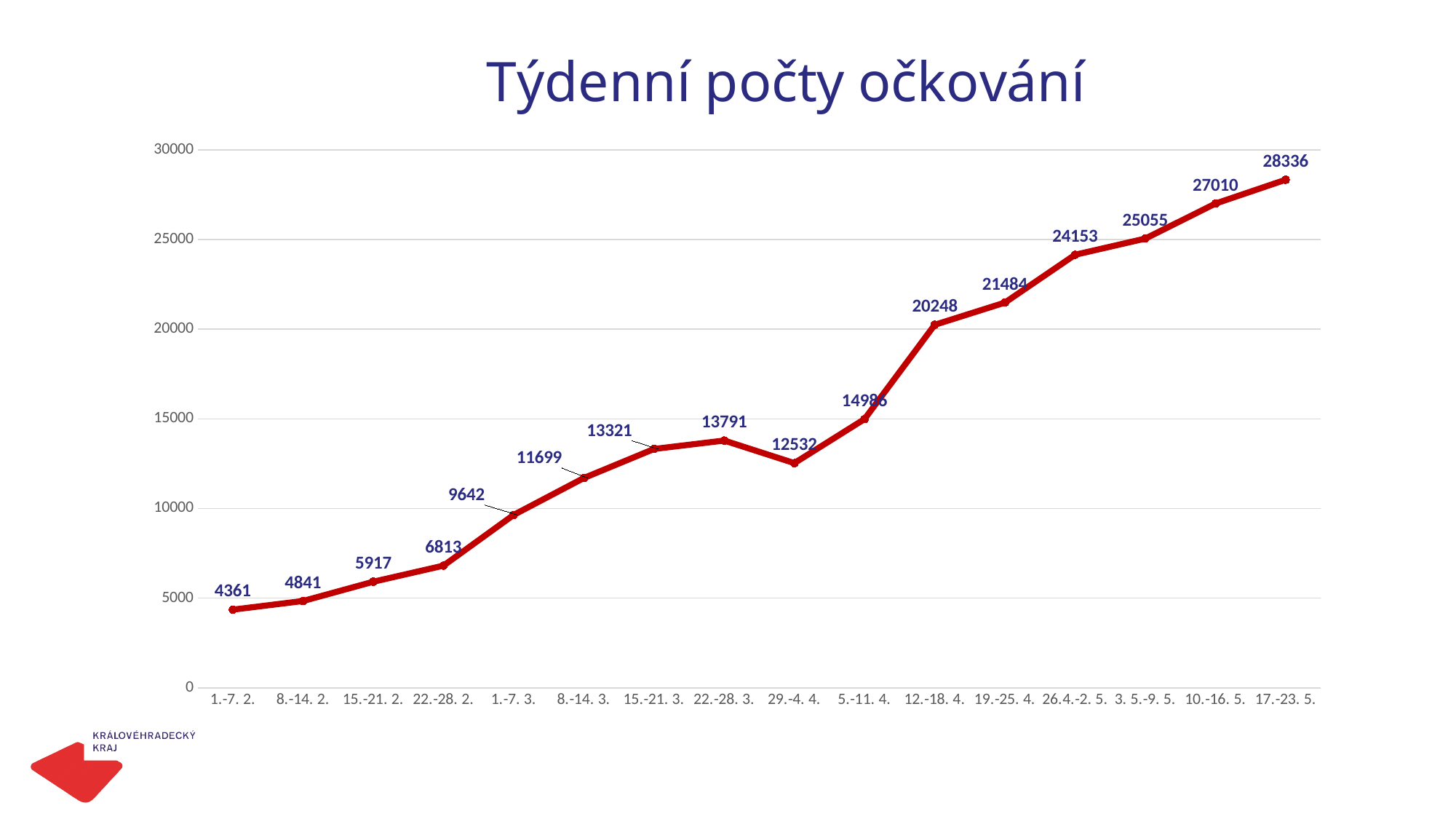
Which is larger, the value for 22.-28. 3. or the value for 29.-4. 4.? 22.-28. 3. How many weeks are plotted on the chart? 16 What is the title of the chart? Týdenní počty očkování What is the value for the week 29.-4. 4.? 12532 What is the value for the week 1.-7. 2.? 4361 Do the values generally rise or fall from left to right along the x axis? rise Which week has the highest value? 17.-23. 5. What type of chart is shown on the slide? line chart Which week has the lowest value? 1.-7. 2. What is the value for the week 12.-18. 4.? 20248 What is the difference between the values for 17.-23. 5. and 10.-16. 5.? 1326 What is the difference between the values for 12.-18. 4. and 5.-11. 4.? 5262